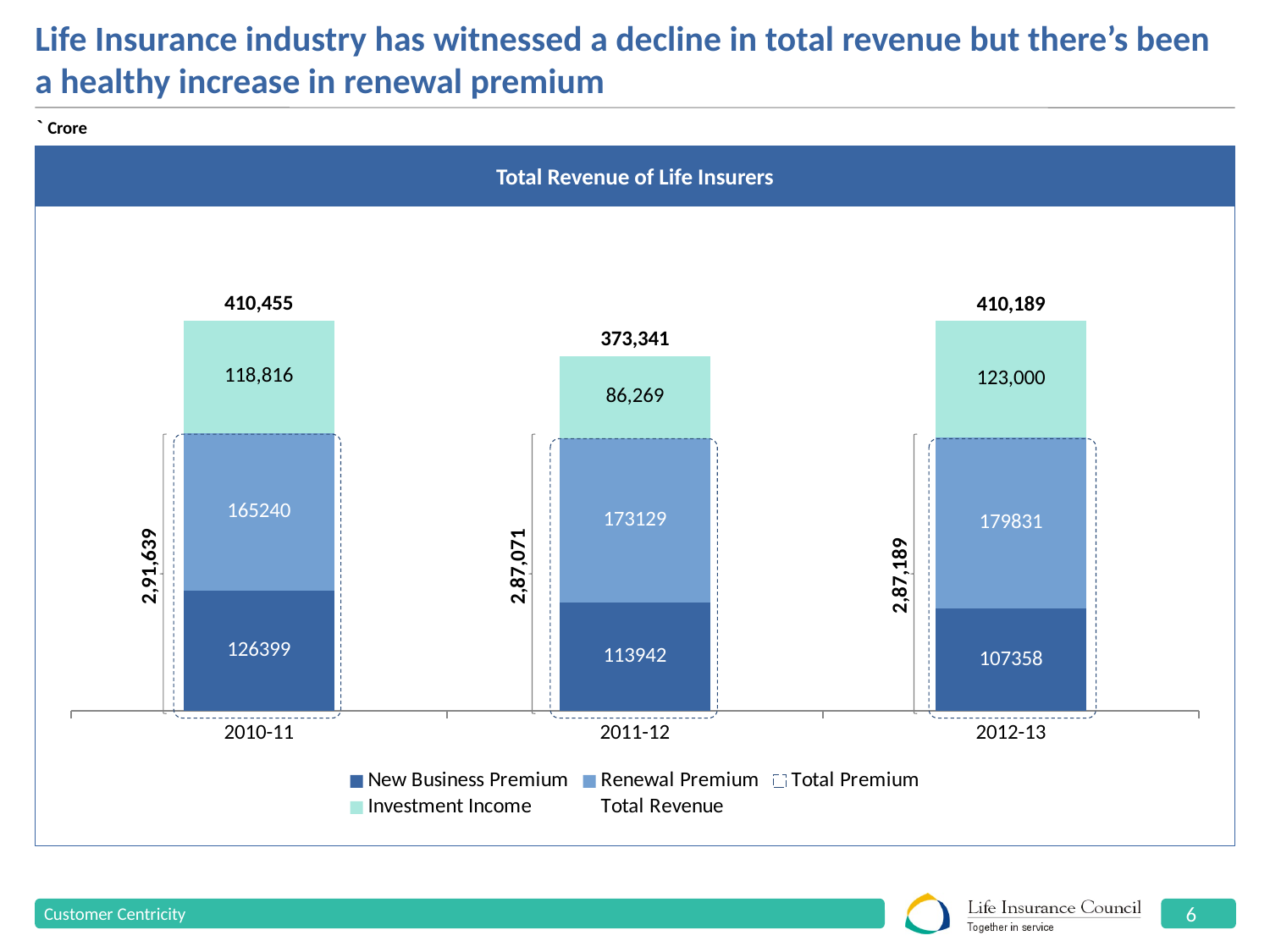
What is the New Business Premium for 2010-11? 126399 Which year has the highest Renewal Premium? 2012-13 What is the Total Revenue for 2010-11? 410,455 What is the Investment Income for 2011-12? 86,269 What type of chart is shown? stacked bar chart What is the Renewal Premium for 2012-13? 179831 Is the New Business Premium larger in 2010-11 or in 2012-13? 2010-11 What is the difference in Investment Income between 2012-13 and 2011-12? 36,731 Does the Renewal Premium rise or fall from 2010-11 to 2012-13? rise How many years are shown on the x axis? 3 Which year has the lowest Total Revenue? 2011-12 What is the Total Premium for 2011-12? 2,87,071